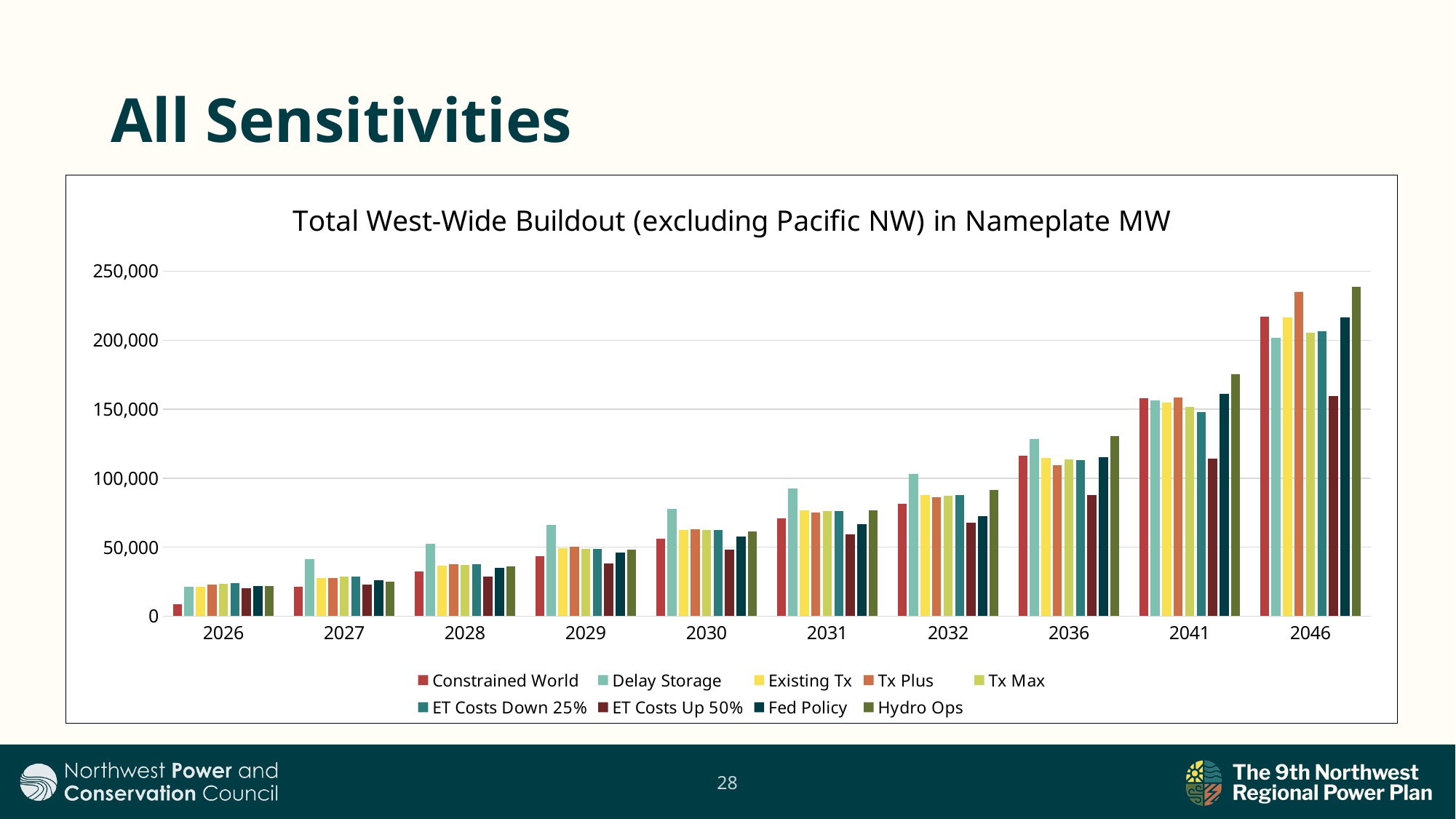
Which series has the lowest value in 2046? ET Costs Up 50% Is the value for Constrained World in 2046 greater or less than 200,000? greater Which series has the lowest value in 2026? Constrained World Which series has the highest value in 2031? Delay Storage How many series does the legend list? 9 Do the values generally rise or fall from 2026 to 2046? Rise In 2046, which is larger: Constrained World or Delay Storage? Constrained World Is the value for ET Costs Up 50% in 2041 greater or less than 100,000? greater How many years are shown along the x axis? 10 What kind of chart is shown on the slide? Bar chart Is the value for Constrained World in 2029 greater or less than 50,000? less What is the title of the chart? Total West-Wide Buildout (excluding Pacific NW) in Nameplate MW